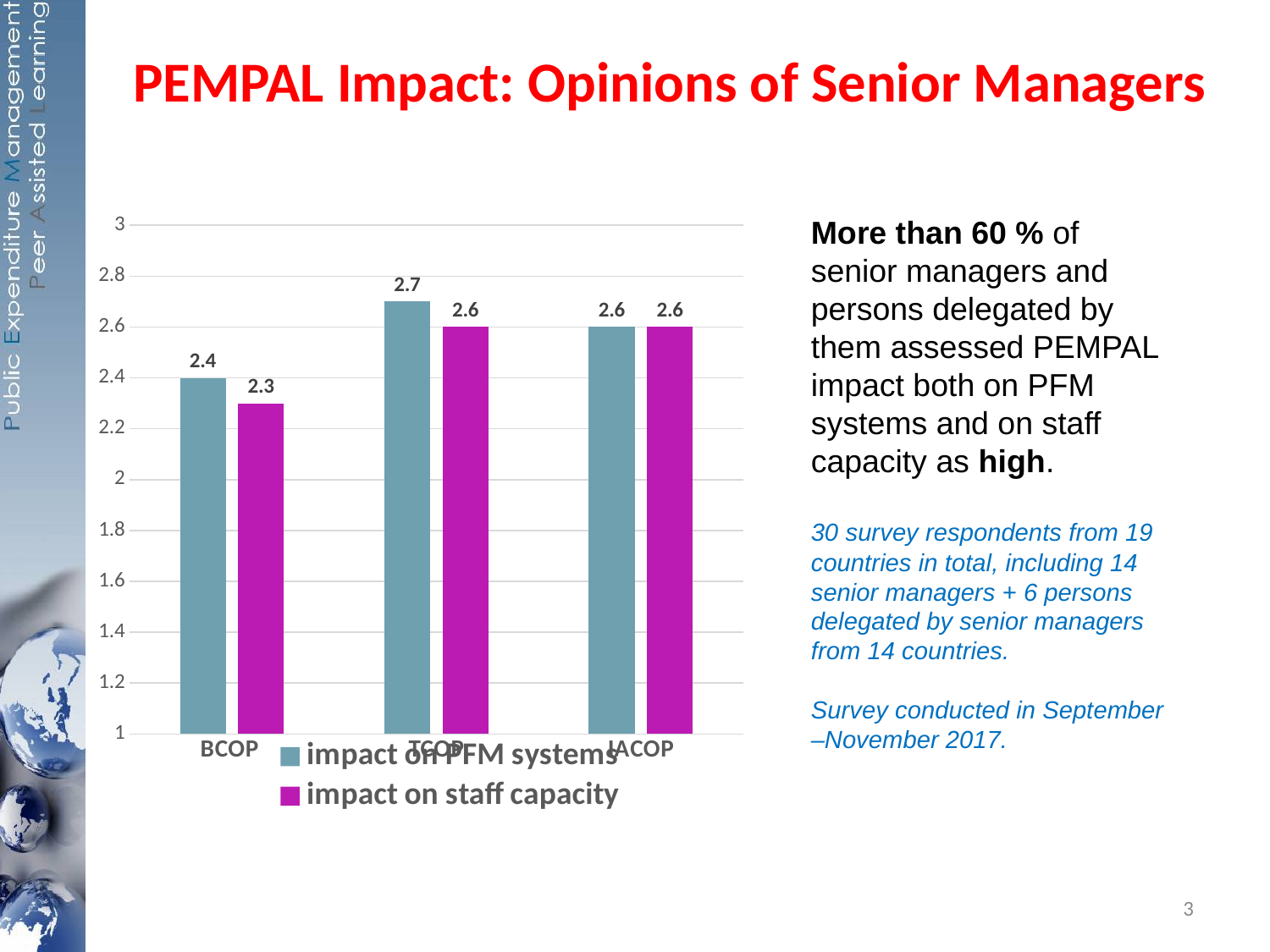
How many categories are shown on the x axis of the chart? 3 What is the difference between the impact on PFM systems values for TCOP and BCOP? 0.3 Which category has the lowest value for impact on staff capacity? BCOP What is the value for impact on staff capacity for BCOP? 2.3 How many series does the legend list? 2 What is the value for impact on staff capacity for IACOP? 2.6 For BCOP, which series has the larger value: impact on PFM systems or impact on staff capacity? impact on PFM systems What is the value for impact on PFM systems for BCOP? 2.4 Which category has the highest value for impact on PFM systems? TCOP What kind of chart is shown on the slide? bar chart What colour are the bars for the impact on staff capacity series? magenta What is the value for impact on PFM systems for TCOP? 2.7